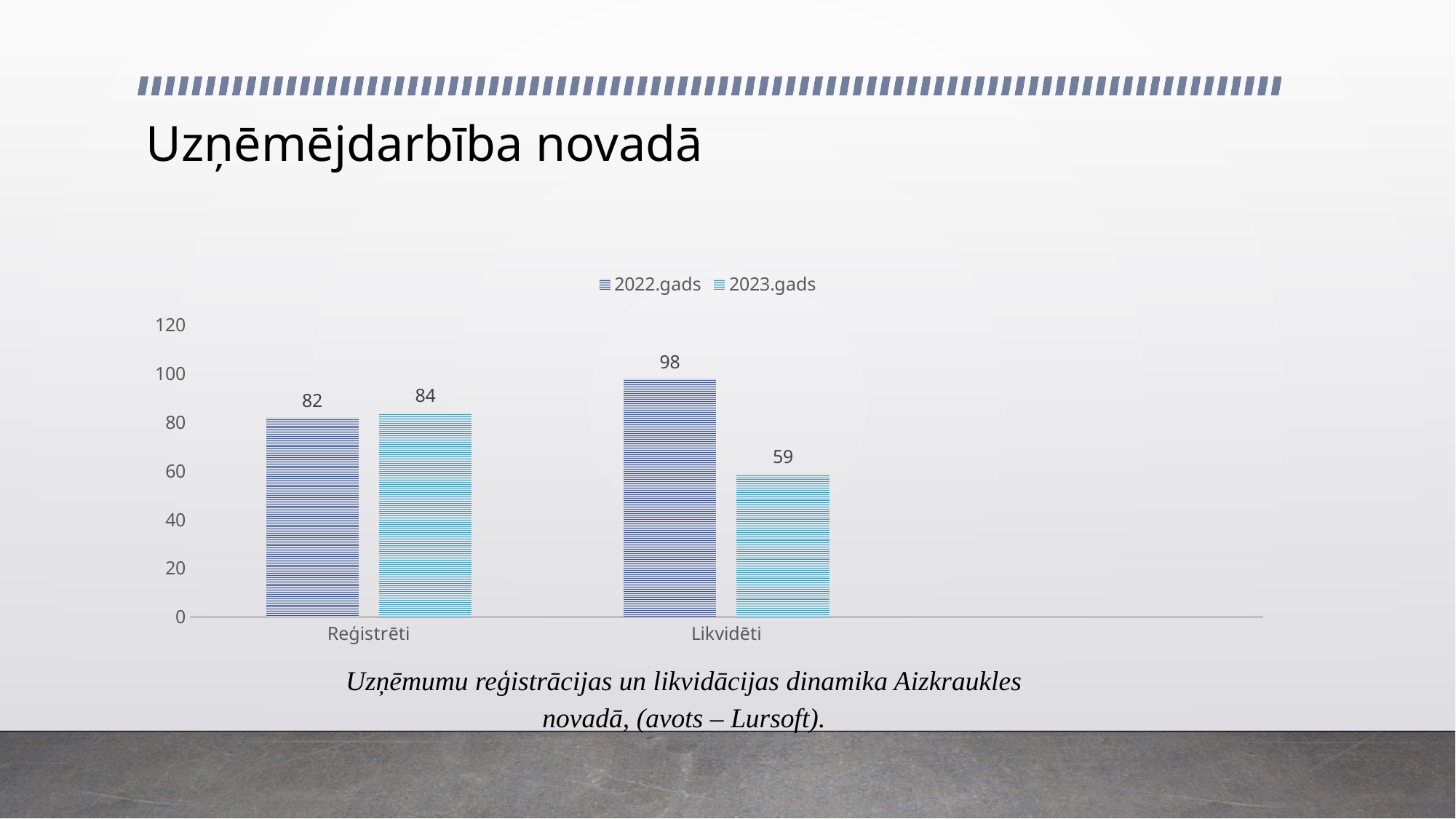
What is the value for Reģistrēti in the 2022.gads series? 82 What are the two series names listed in the legend? 2022.gads and 2023.gads Which category has the highest value in the 2022.gads series? Likvidēti How many categories are shown on the x axis? 2 What is the value for Likvidēti in the 2022.gads series? 98 Which is larger for Likvidēti: the 2022.gads value or the 2023.gads value? 2022.gads What is the difference between the 2022.gads and 2023.gads values for Likvidēti? 39 What is the value for Reģistrēti in the 2023.gads series? 84 What kind of chart is shown on the slide? bar chart What is the value for Likvidēti in the 2023.gads series? 59 How many series does the legend list? 2 Which category has the lowest value in the 2023.gads series? Likvidēti